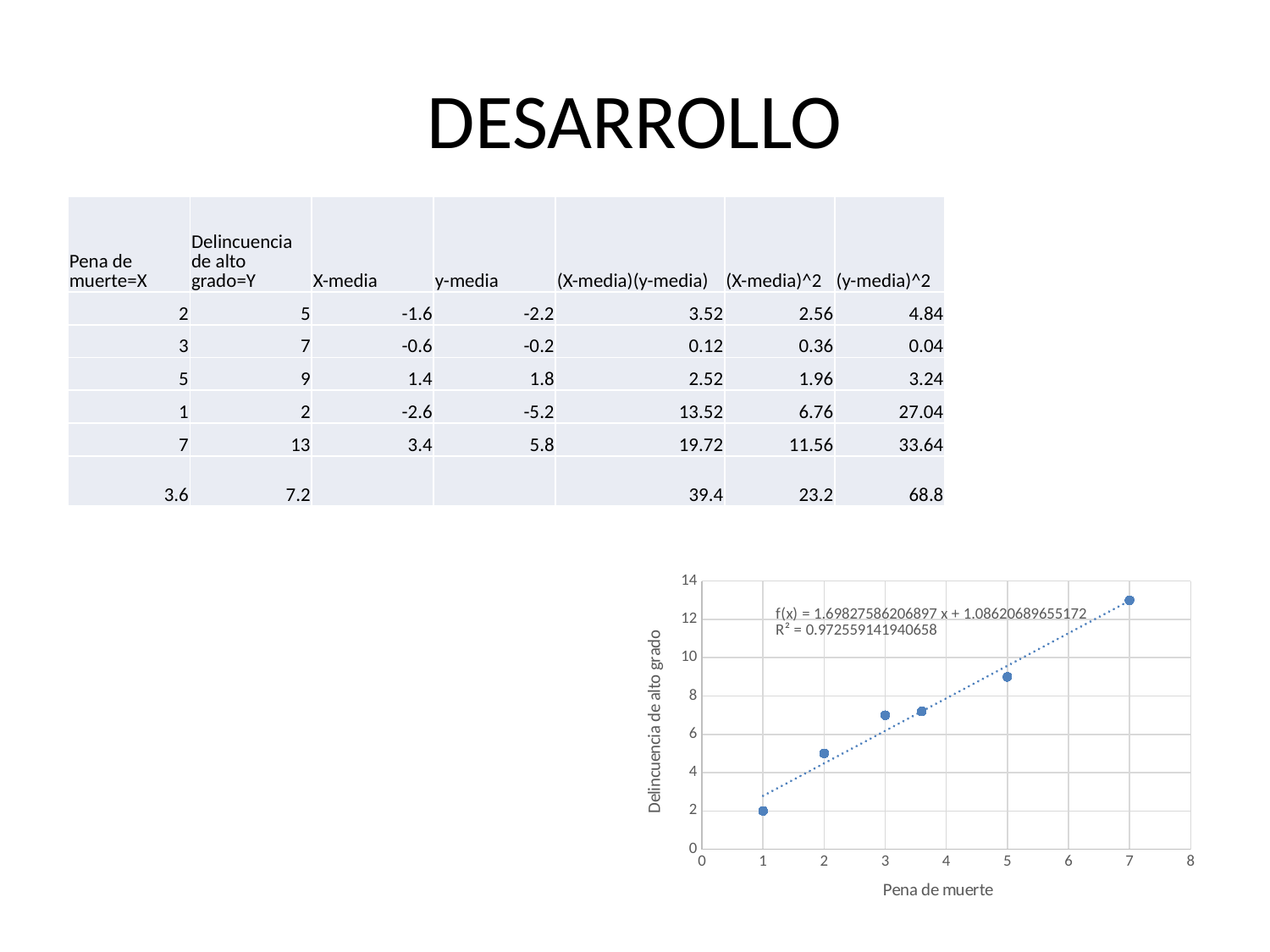
What is the title of the x axis of the chart? Pena de muerte Is the Delincuencia de alto grado value for the point at Pena de muerte = 2 greater or less than 4? greater What is the Delincuencia de alto grado value for the point at Pena de muerte = 1? 2 What kind of chart is shown on the slide? scatter chart Do the plotted values rise or fall as Pena de muerte increases along the x axis? rise How many data points are plotted in the chart? 6 At which Pena de muerte value is the plotted Delincuencia de alto grado highest? 7 Is the Delincuencia de alto grado value for the point at Pena de muerte = 3 greater or less than 8? less Which point has the larger Delincuencia de alto grado value: the one at Pena de muerte = 5 or the one at Pena de muerte = 3? Pena de muerte = 5 Is the Delincuencia de alto grado value for the point at Pena de muerte = 7 greater or less than 12? greater What is the title of the y axis of the chart? Delincuencia de alto grado At which Pena de muerte value is the plotted Delincuencia de alto grado lowest? 1